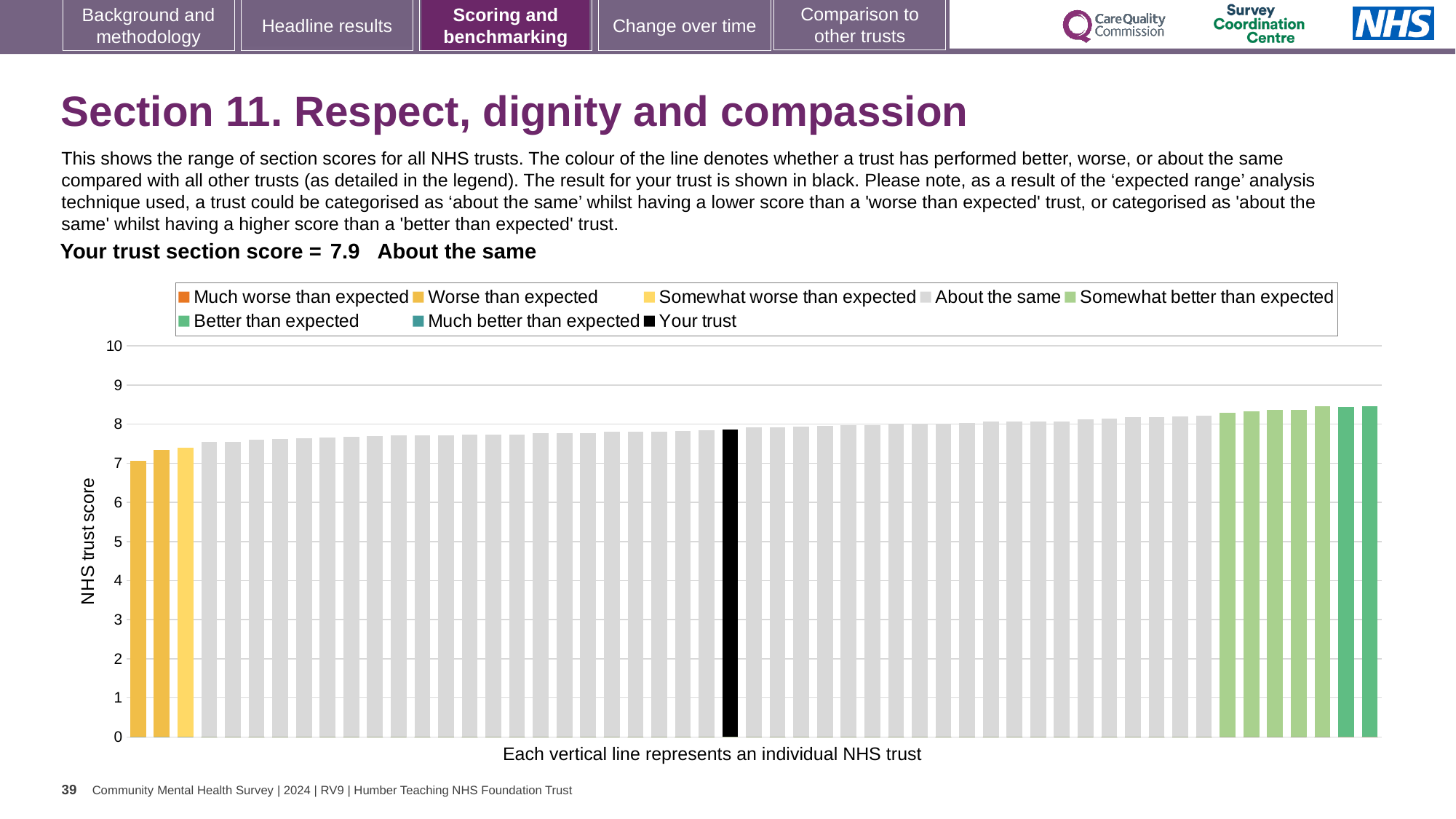
Which is larger: the score for your trust or the score of the leftmost bar? your trust What is the section score for your trust shown on the slide? 7.9 How many bars are coloured in a yellow shade (worse or somewhat worse than expected)? 3 What kind of chart is shown on the slide? bar chart Which category is your trust placed in for this section? About the same Is the value for the rightmost (highest) bar greater or less than 8? greater How many entries does the chart legend list? 8 What colour is the bar representing your trust? black Which is larger: the score for your trust or the score of the rightmost bar? the rightmost bar Is the value for your trust greater or less than 7? greater Do the bar values rise or fall moving from left to right along the x axis? rise Is the value for the leftmost (lowest) bar greater or less than 8? less